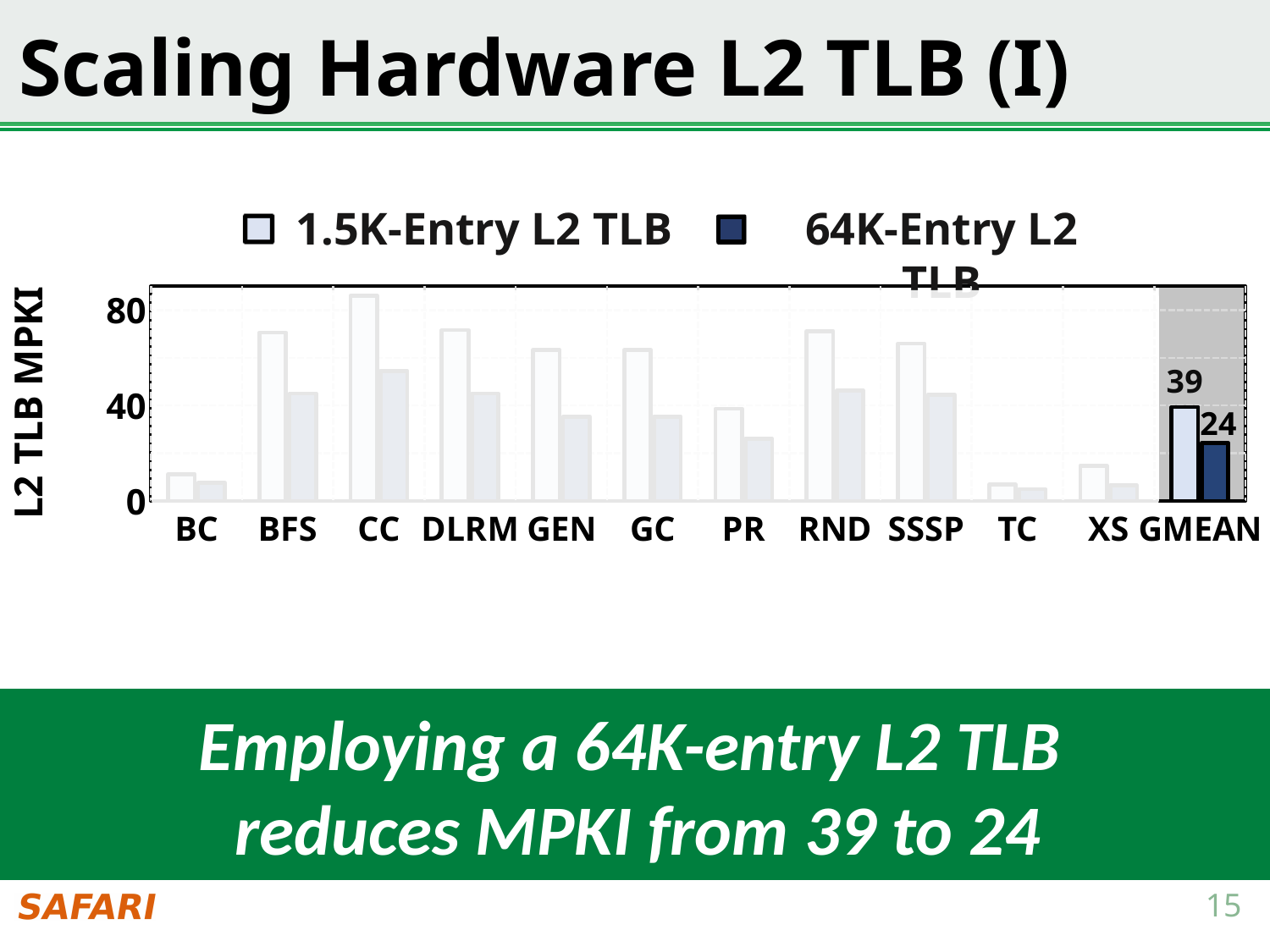
What is the value for the 64K-Entry L2 TLB series at GMEAN? 24 How many categories are shown on the x axis of the chart? 12 Which category has the highest value for the 1.5K-Entry L2 TLB series? CC At GMEAN, which series has the larger value: 1.5K-Entry L2 TLB or 64K-Entry L2 TLB? 1.5K-Entry L2 TLB How many series does the chart's legend list? 2 What is the value for the 1.5K-Entry L2 TLB series at GMEAN? 39 Is the 64K-Entry L2 TLB value for PR greater or less than 40? less Is the 64K-Entry L2 TLB value for CC greater or less than 40? greater What kind of chart is shown on the slide? bar chart Is the 1.5K-Entry L2 TLB value for CC greater or less than 80? greater What is the difference between the 1.5K-Entry L2 TLB and 64K-Entry L2 TLB values at GMEAN? 15